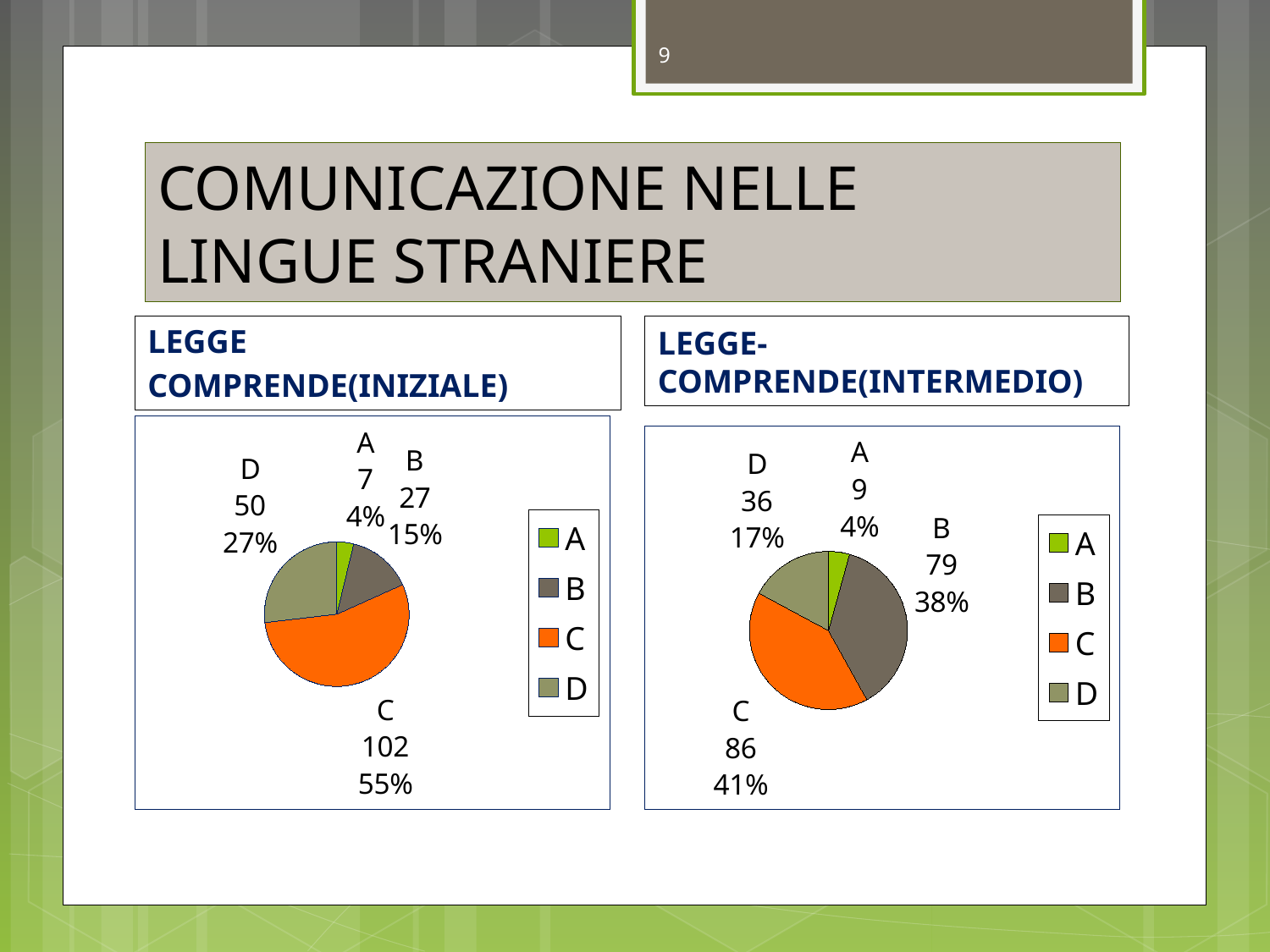
How many categories does the LEGGE COMPRENDE(INIZIALE) chart show? 4 In the LEGGE-COMPRENDE(INTERMEDIO) chart, which is larger, the value for B or the value for D? B In the LEGGE COMPRENDE(INIZIALE) chart, what is the difference between the values for D and B? 23 In the LEGGE-COMPRENDE(INTERMEDIO) chart, which category has the smallest slice? A In the LEGGE COMPRENDE(INIZIALE) chart, what is the value for C? 102 In the LEGGE-COMPRENDE(INTERMEDIO) chart, what is the difference between the values for C and B? 7 What kind of chart is the LEGGE-COMPRENDE(INTERMEDIO) chart? Pie chart In the LEGGE COMPRENDE(INIZIALE) chart, which category has the largest slice? C In the LEGGE COMPRENDE(INIZIALE) chart, what colour is the slice for C? Orange In the LEGGE-COMPRENDE(INTERMEDIO) chart, what is the value for B? 79 In the LEGGE COMPRENDE(INIZIALE) chart, what percentage share does D have? 27% In the LEGGE-COMPRENDE(INTERMEDIO) chart, what percentage share does C have? 41%